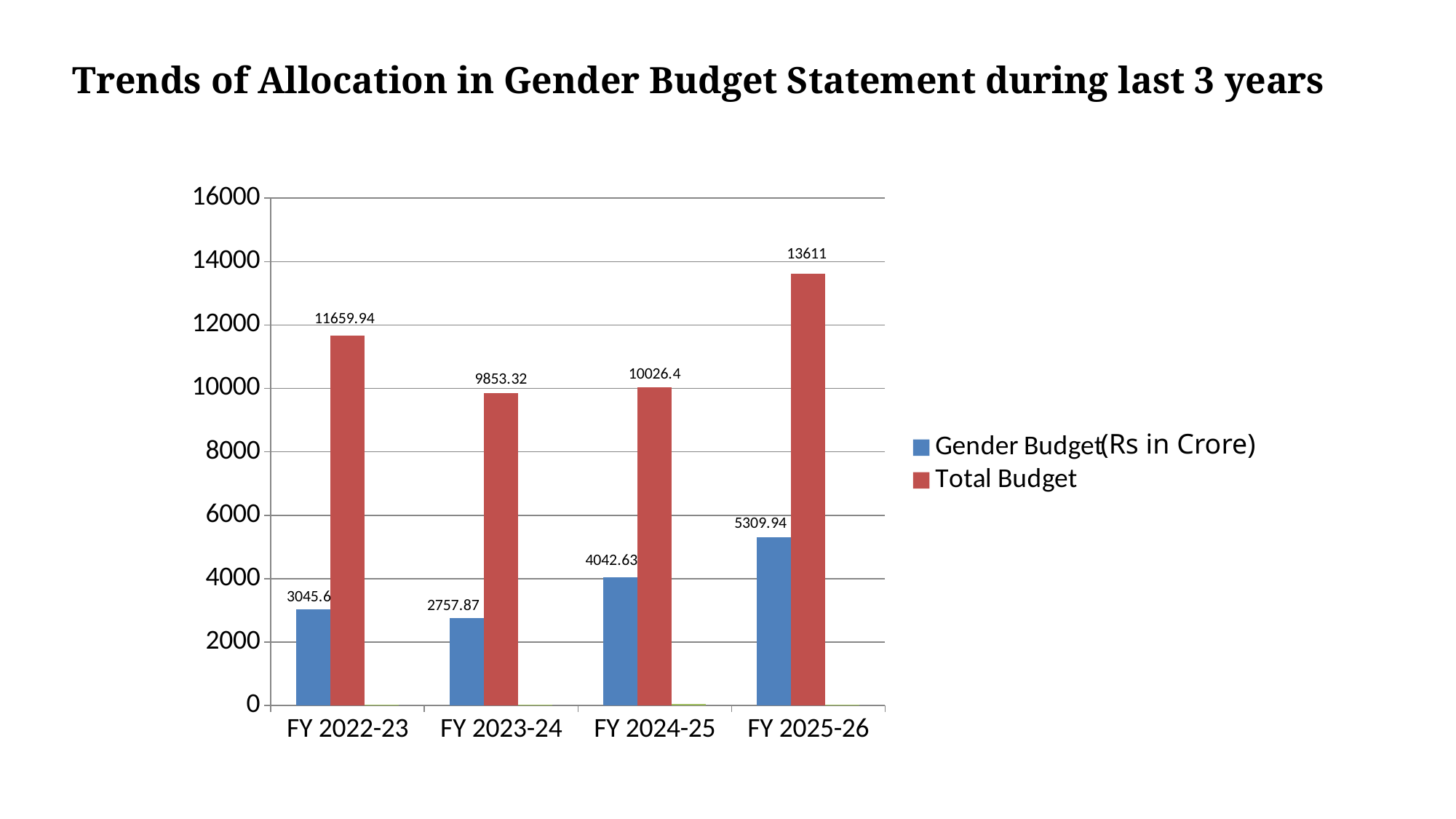
Which fiscal year has the highest Total Budget? FY 2025-26 Which fiscal year has the lowest Gender Budget? FY 2023-24 By how much did the Gender Budget increase from FY 2022-23 to FY 2025-26? 2264.34 What type of chart is shown on the slide? Bar chart Which is larger: the Total Budget for FY 2023-24 or the Total Budget for FY 2024-25? FY 2024-25 What is the Total Budget value for FY 2024-25? 10026.4 What is the difference between the Total Budget and the Gender Budget in FY 2025-26? 8301.06 What is the Gender Budget value for FY 2025-26? 5309.94 What is the Gender Budget value for FY 2023-24? 2757.87 How many fiscal years are shown on the x axis? 4 What is the Total Budget value for FY 2022-23? 11659.94 How many series does the legend list? 2